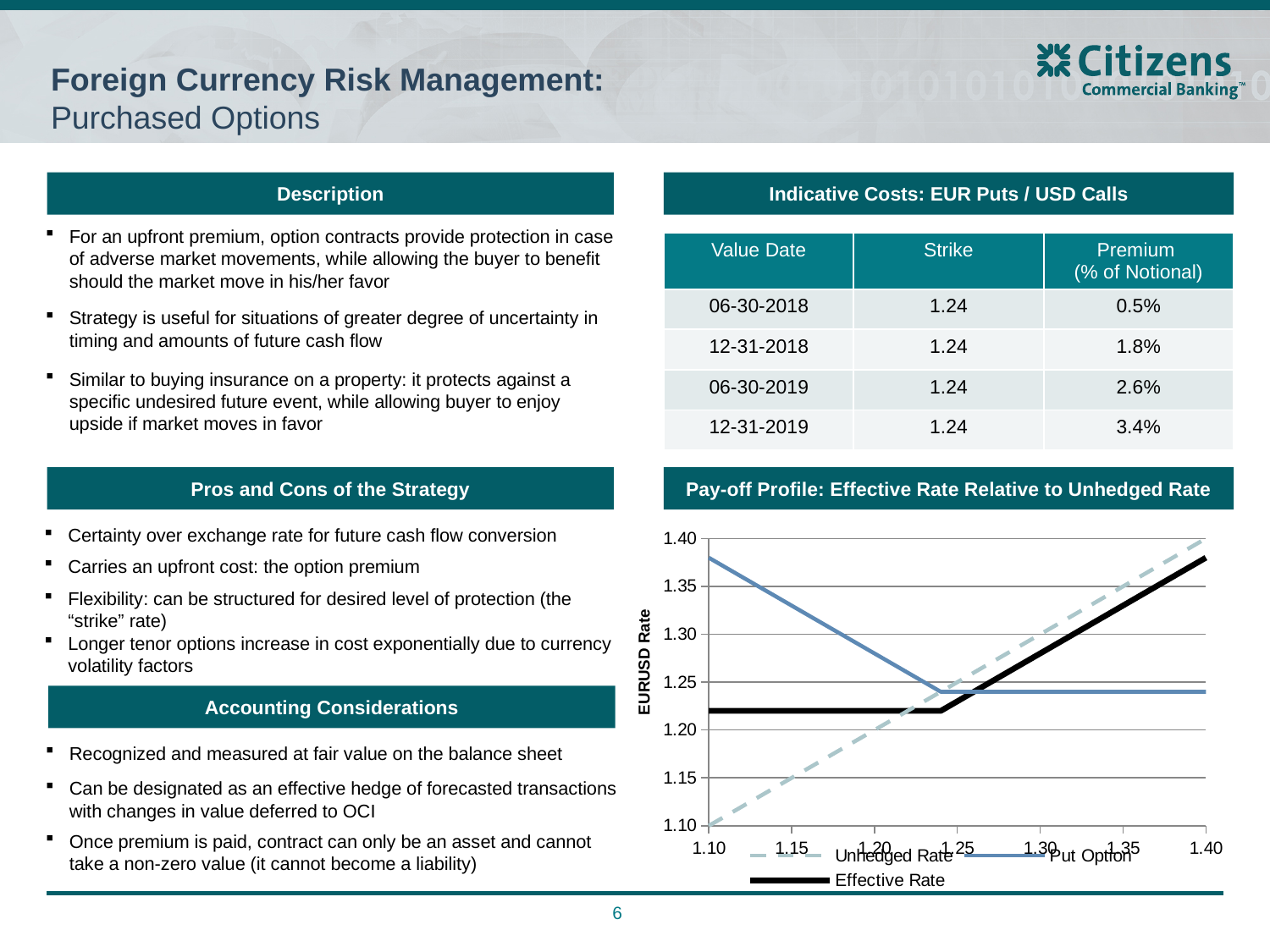
What is the highest value shown on the vertical axis of the Pay-off Profile chart? 1.40 Which series in the Pay-off Profile chart is drawn as a dashed line? Unhedged Rate In the Pay-off Profile chart, does the Unhedged Rate line rise or fall as the x-axis value increases? Rise What kind of chart is shown under "Pay-off Profile: Effective Rate Relative to Unhedged Rate"? Line chart In the Pay-off Profile chart, is the Effective Rate value at x = 1.20 greater or less than 1.25? less In the Pay-off Profile chart, is the Put Option value at x = 1.10 greater or less than 1.35? greater In the Pay-off Profile chart, does the Put Option line rise or fall between x = 1.10 and x = 1.25? Fall In the Pay-off Profile chart, is the Effective Rate value at x = 1.40 greater or less than 1.35? greater How many series does the legend of the Pay-off Profile chart list? 3 In the Pay-off Profile chart, at x = 1.10, which is larger: the Put Option value or the Effective Rate value? Put Option What is the label on the vertical axis of the Pay-off Profile chart? EURUSD Rate In the Pay-off Profile chart, at x = 1.40, which is larger: the Unhedged Rate value or the Put Option value? Unhedged Rate